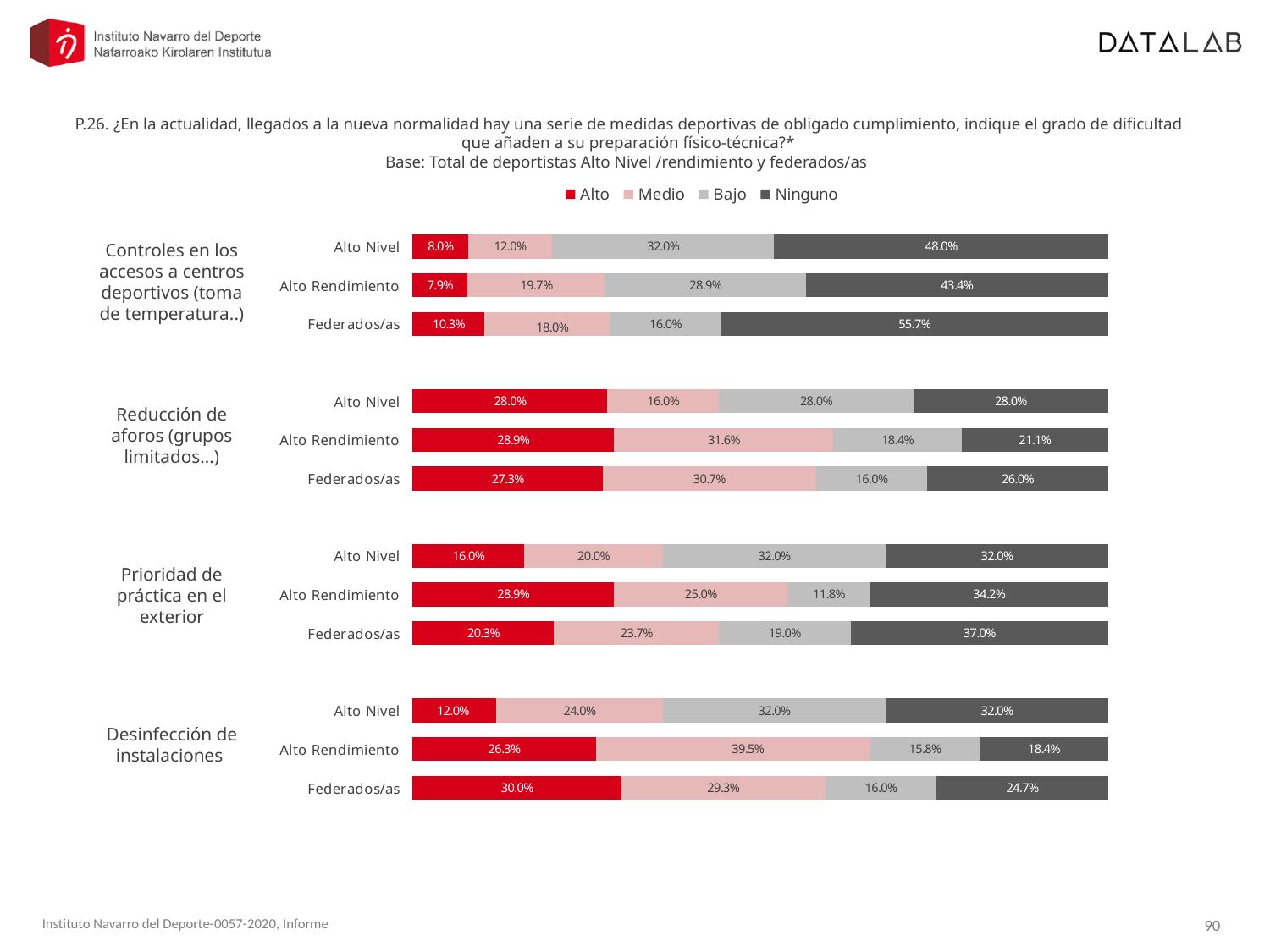
How many measures (row groups) are shown in the chart? 4 What kind of chart is shown on the slide? stacked bar chart What is the 'Alto' value for Alto Nivel under 'Reducción de aforos'? 28.0% What is the 'Medio' value for Alto Rendimiento under 'Desinfección de instalaciones'? 39.5% What is the 'Ninguno' value for Federados/as under 'Controles en los accesos a centros deportivos'? 55.7% Under 'Controles en los accesos a centros deportivos', which group has the lowest 'Alto' value? Alto Rendimiento What is the difference between the 'Ninguno' values for Federados/as and Alto Rendimiento under 'Controles en los accesos a centros deportivos'? 12.3% Under 'Reducción de aforos', is the 'Medio' value larger for Alto Nivel or for Alto Rendimiento? Alto Rendimiento Under 'Prioridad de práctica en el exterior', which group has the highest 'Ninguno' value? Federados/as Under 'Desinfección de instalaciones', is the 'Alto' value larger for Alto Nivel or for Federados/as? Federados/as Which legend entry is shown in red? Alto How many series does the legend list? 4